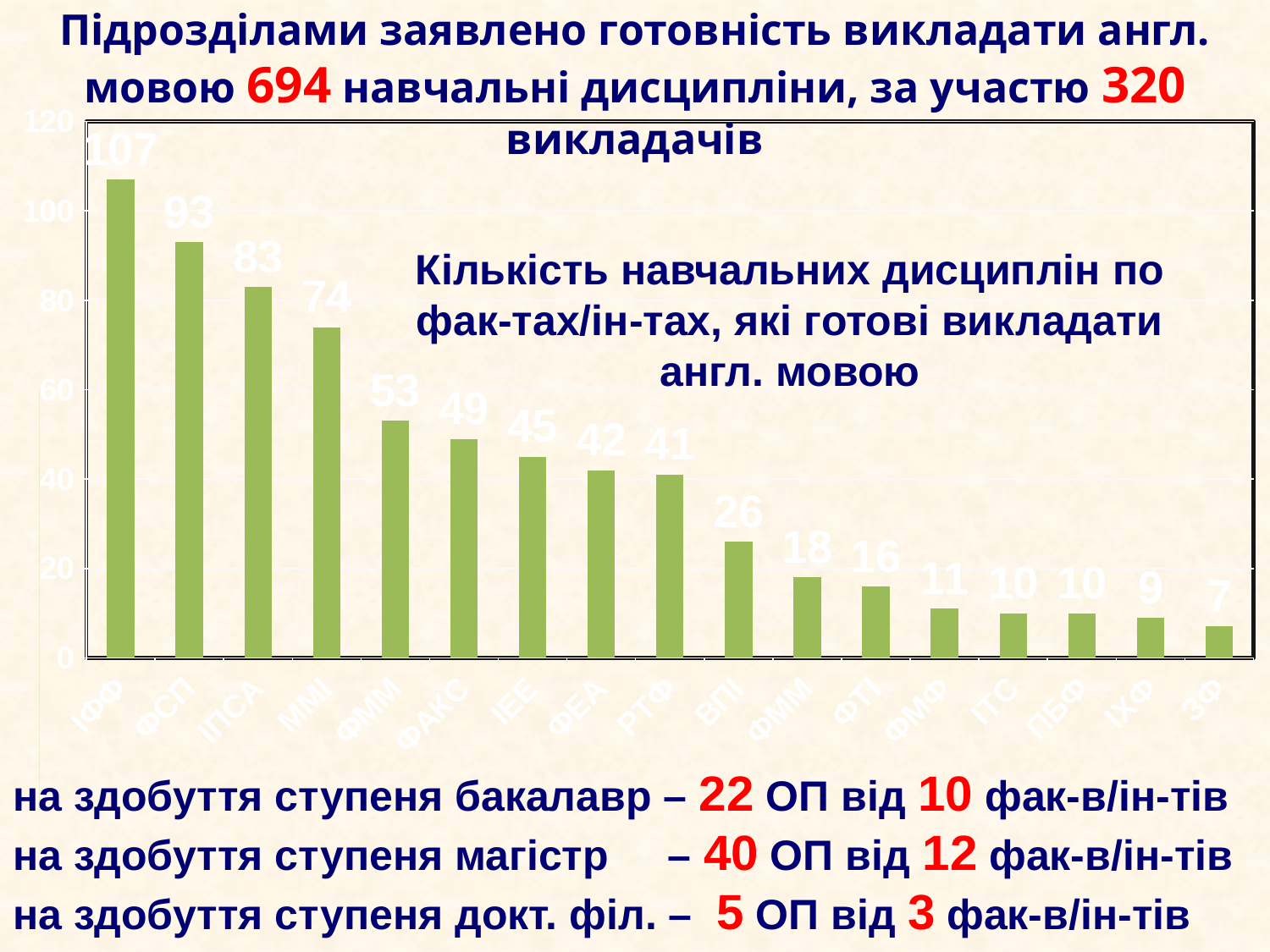
What type of chart is shown on the slide? bar chart What is the value for ФАКС? 49 What is the value of the highest bar in the chart? 107 How many bars (categories) does the chart show? 17 What is the difference between the values for ІФФ and ФСП? 14 What is the value for ФСП? 93 What is the title of the chart? Кількість навчальних дисциплін по фак-тах/ін-тах, які готові викладати англ. мовою Which category has the highest value in the chart? ІФФ What is the value of the lowest bar (the last bar, ЗФ)? 7 What is the value for ІПСА? 83 Do the values rise or fall from left to right along the x axis? fall Which is larger, the value for ММІ or the value for ФЕА? ММІ